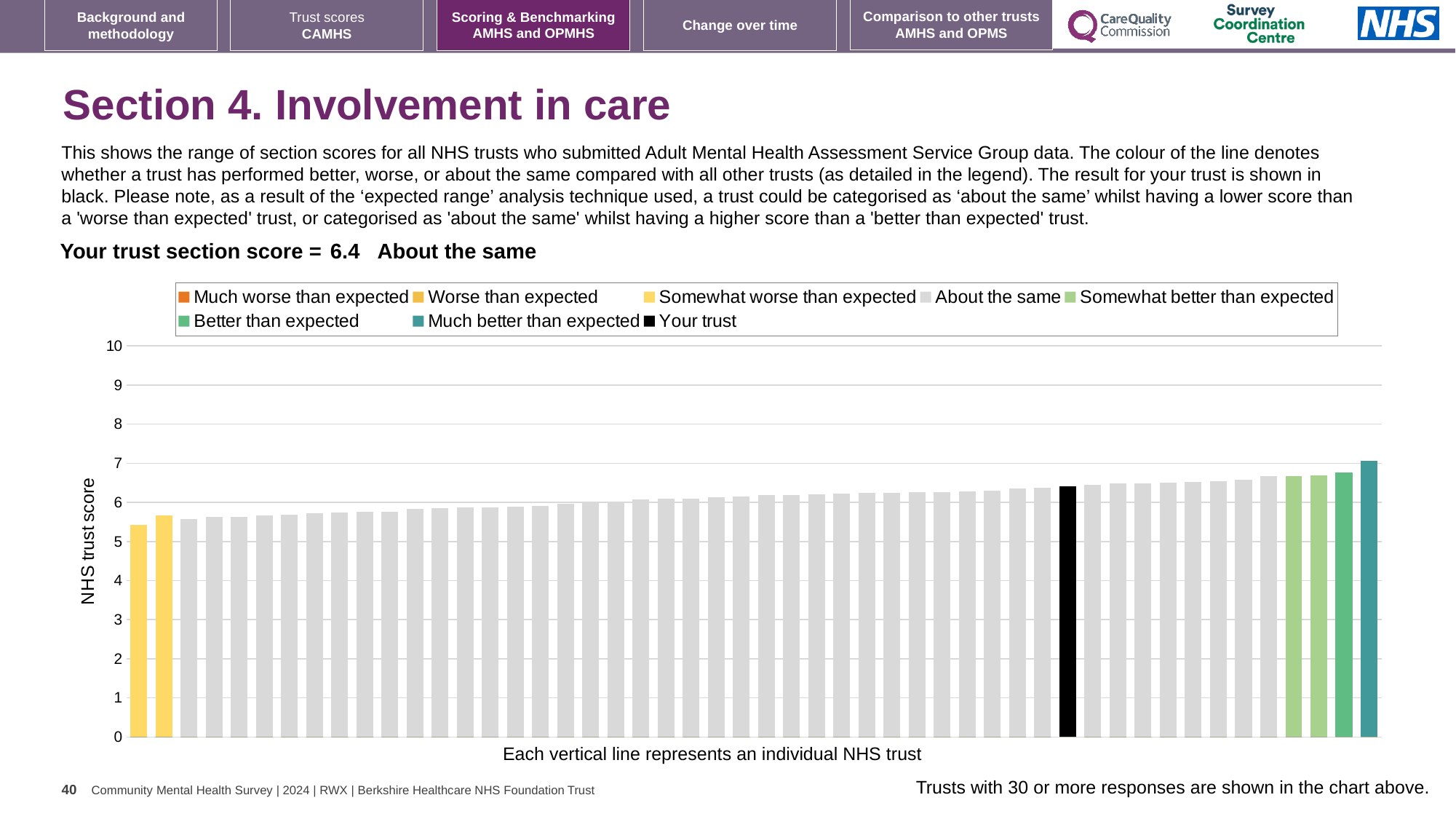
Is the 'Your trust' bar higher or lower than the yellow 'Worse than expected' bars? higher What kind of chart is shown on the slide? bar chart Is the value of the lowest bar in the chart greater or less than 5? greater Do the bar values rise or fall from left to right along the x axis? rise What is the label on the vertical axis of the chart? NHS trust score Which legend category does the highest bar in the chart belong to? Much better than expected What is the section score for your trust shown on the slide? 6.4 Is the value of the black 'Your trust' bar greater or less than 6? greater How many bars are coloured 'Somewhat better than expected' (light green)? 2 How many entries does the chart legend list? 8 Is the value of the lowest bar in the chart greater or less than 6? less